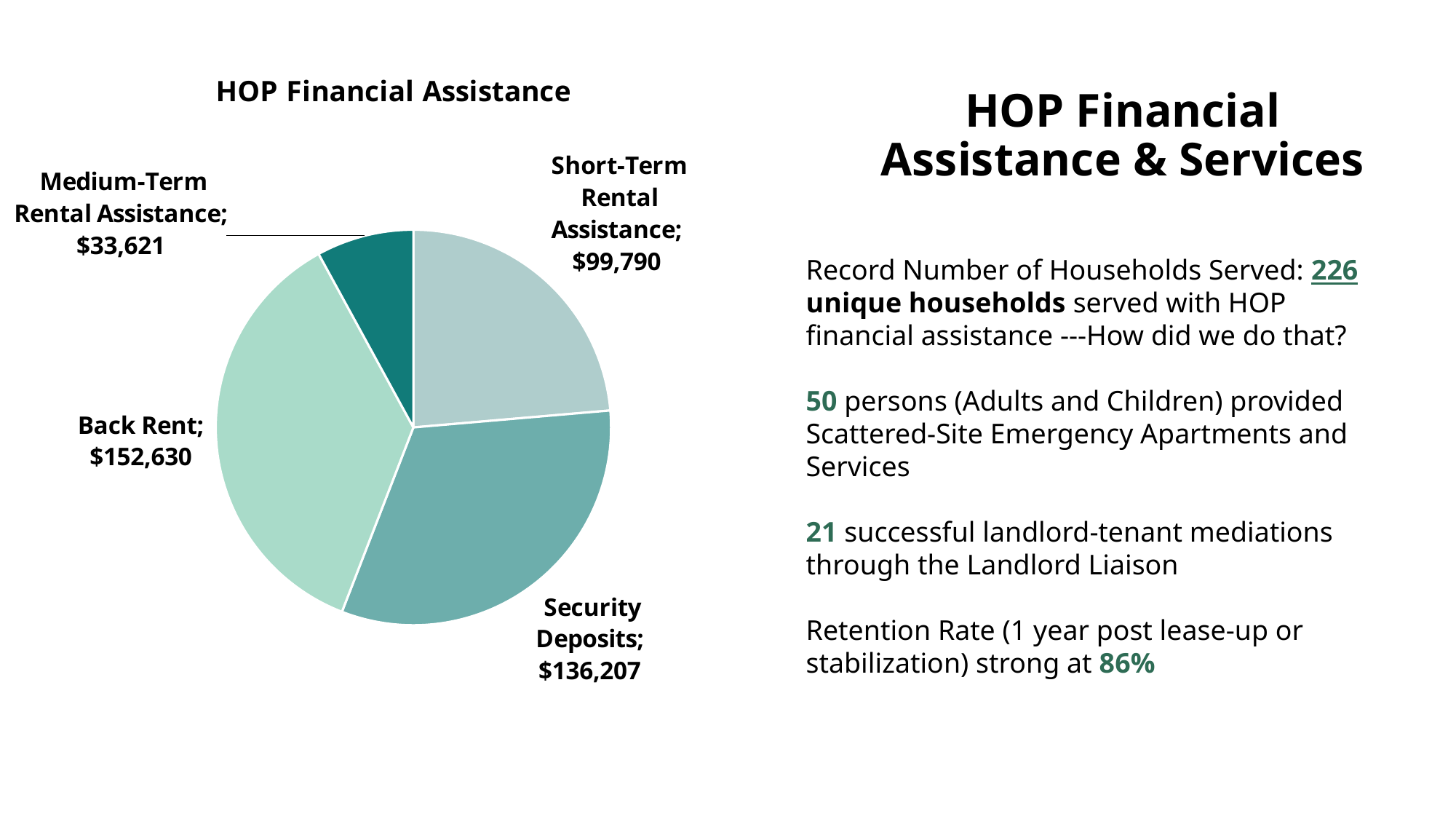
How many slices does the pie chart have? 4 What is the value for Short-Term Rental Assistance? $99,790 Which category has the smallest value? Medium-Term Rental Assistance What is the value for Security Deposits? $136,207 What is the total of all four categories in the pie chart? $422,248 What is the title of the chart? HOP Financial Assistance Which category has the largest value? Back Rent What is the value for Medium-Term Rental Assistance? $33,621 Which is larger, Short-Term Rental Assistance or Security Deposits? Security Deposits What is the value for Back Rent? $152,630 What is the difference between Back Rent and Security Deposits? $16,423 What type of chart is shown on the slide? Pie chart